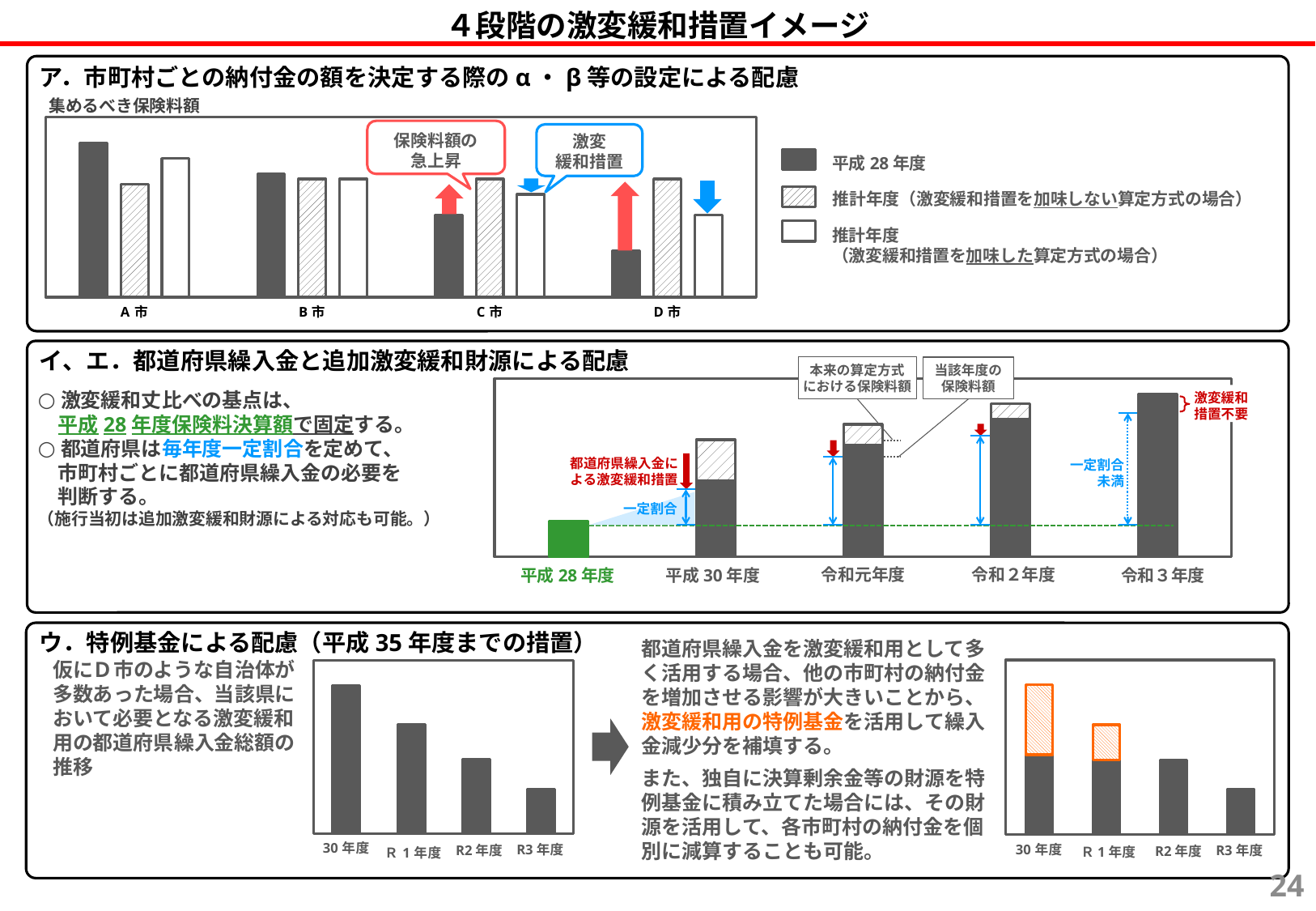
In the bottom-left chart (ウ), do the bars rise or fall from 30年度 to R3年度? fall What kind of chart is the top chart (ア. 集めるべき保険料額)? bar chart In the top chart (ア. 集めるべき保険料額), how many municipalities are shown on the x axis? 4 In the top chart (ア. 集めるべき保険料額), which series is drawn with solid dark grey bars? 平成28年度 In the middle chart (イ、エ), do the bar heights rise or fall from 平成28年度 to 令和3年度? rise In the bottom-right chart (ウ), which fiscal year has the lowest bar? R3年度 In the top chart (ア. 集めるべき保険料額), which municipality has the lowest 平成28年度 bar? D市 In the top chart (ア. 集めるべき保険料額), how many series does the legend list? 3 In the middle chart (イ、エ), which fiscal year has the tallest bar? 令和3年度 In the top chart (ア. 集めるべき保険料額), which municipality has the highest 平成28年度 bar? A市 In the top chart (ア. 集めるべき保険料額), for C市, which is larger: the 平成28年度 bar or the 推計年度 (加味しない) bar? 推計年度 (加味しない) In the middle chart (イ、エ), how many fiscal years are shown on the x axis? 5